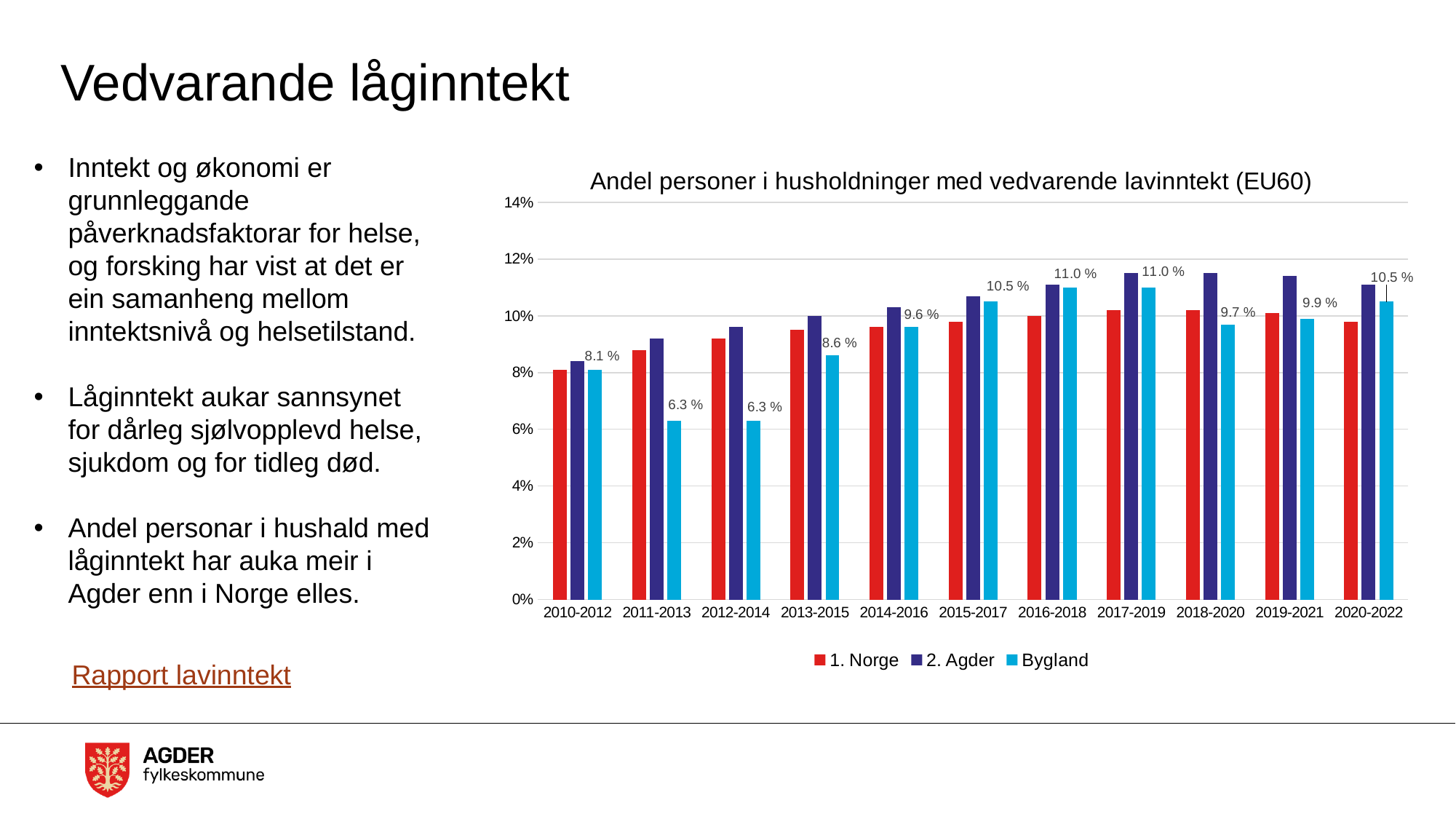
What is the value for Bygland in 2013-2015? 8.6 % What is the difference between the Bygland values for 2017-2019 and 2018-2020? 1.3 percentage points Is the value for 2. Agder in 2017-2019 greater or less than 10%? greater Do the values for 1. Norge rise or fall from 2010-2012 to 2017-2019? Rise What kind of chart is shown on the slide? Bar chart What is the value for Bygland in 2010-2012? 8.1 % Is the value for 1. Norge in 2010-2012 greater or less than 10%? less How many series does the legend list? 3 Which is larger for Bygland: the value for 2015-2017 or the value for 2018-2020? 2015-2017 What is the lowest value shown for Bygland? 6.3 % How many time periods are shown on the x axis? 11 What is the value for Bygland in 2018-2020? 9.7 %